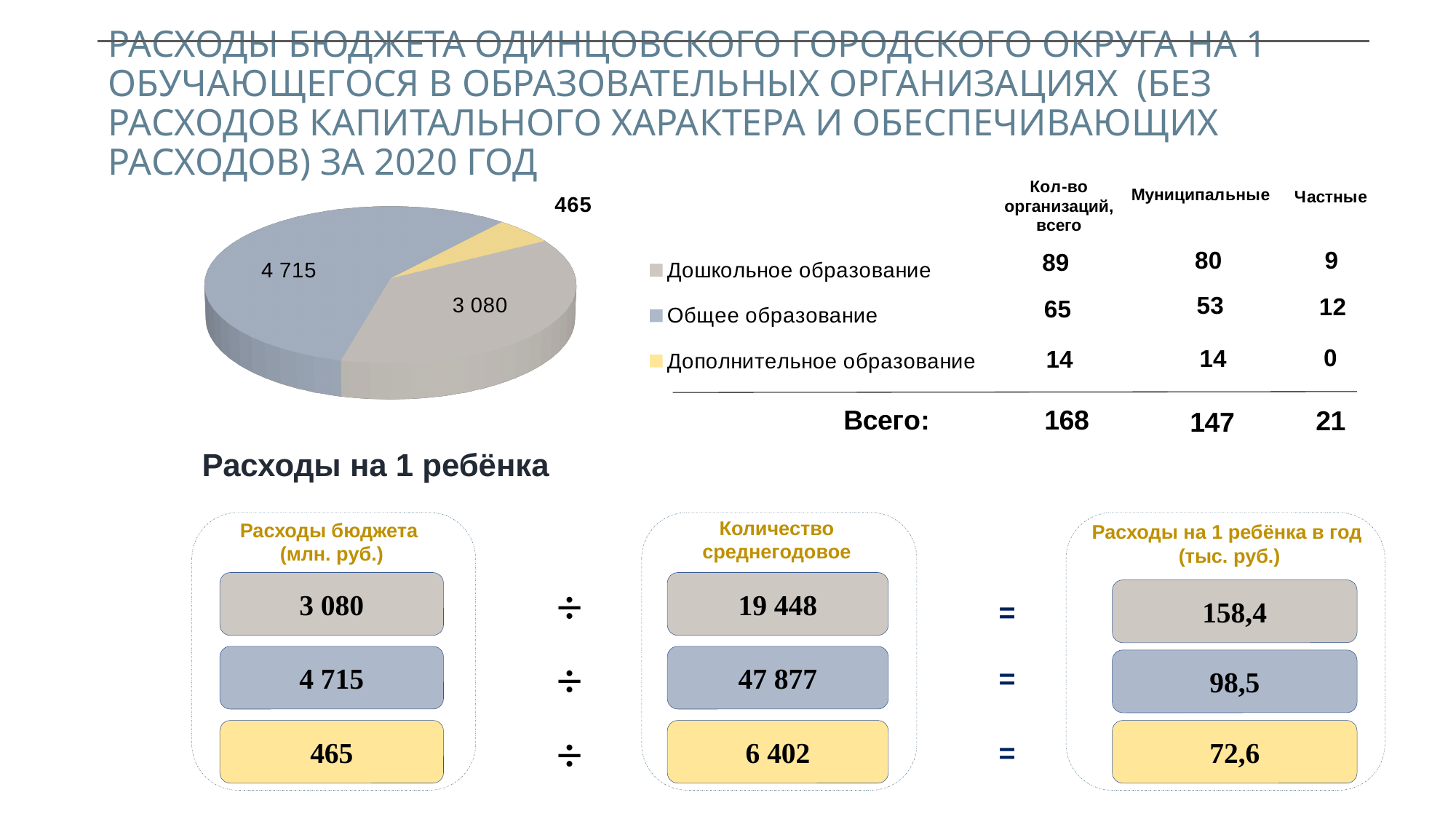
What colour is the slice for Дополнительное образование in the pie chart? yellow How many slices does the pie chart have? 3 Which category has the smallest slice in the pie chart? Дополнительное образование What share of the pie chart does Общее образование represent, to the nearest whole percent? 57% Which is larger in the pie chart: Дошкольное образование or Дополнительное образование? Дошкольное образование What is the total of all slices in the pie chart? 8 260 What is the value shown for Дошкольное образование in the pie chart? 3 080 What is the value shown for Дополнительное образование in the pie chart? 465 What is the value shown for Общее образование in the pie chart? 4 715 What type of chart is shown on the slide? pie chart What is the difference between the values for Общее образование and Дошкольное образование in the pie chart? 1 635 Which category has the largest slice in the pie chart? Общее образование